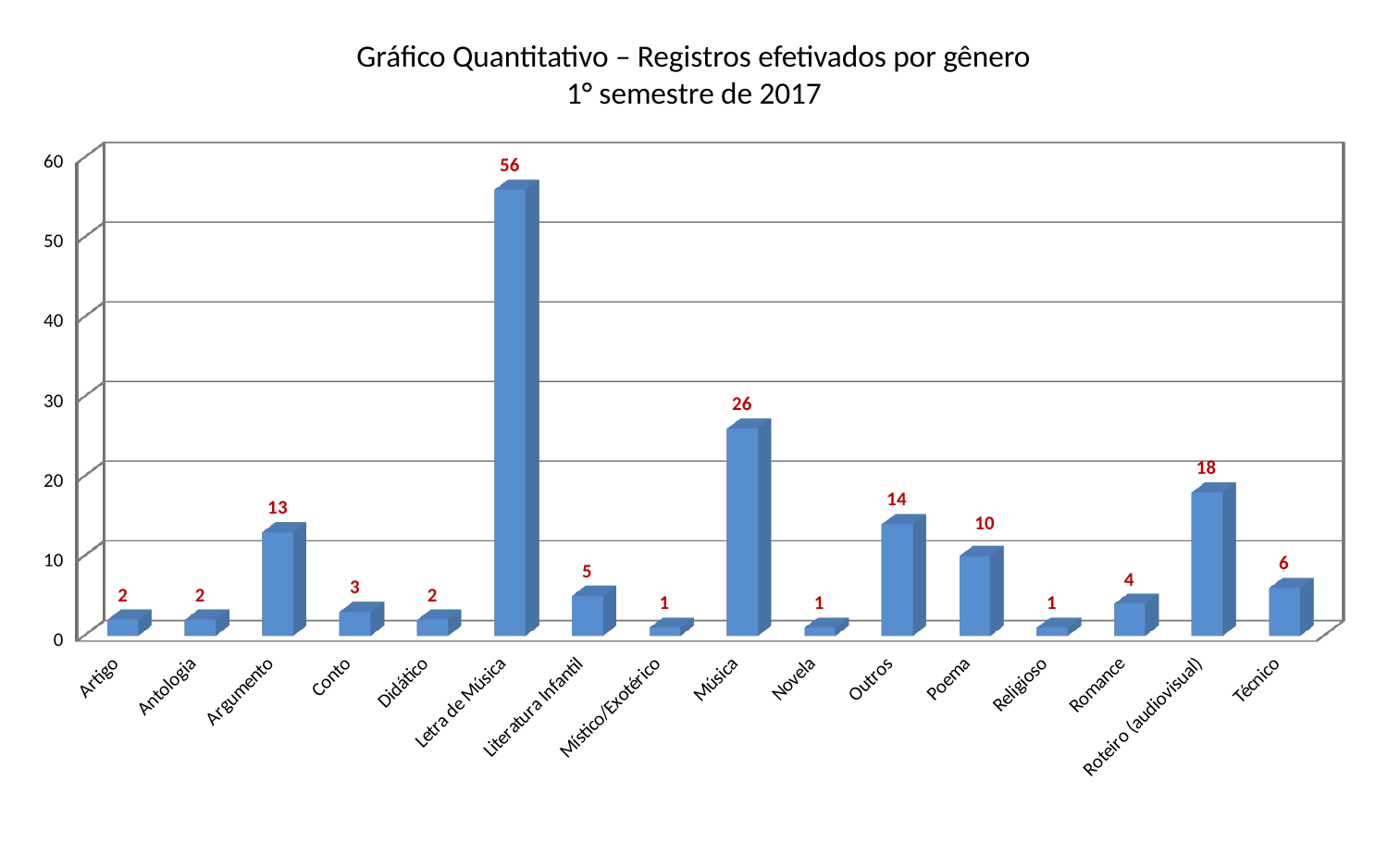
How many categories are shown on the x axis? 16 What is the difference between the values for Letra de Música and Música? 30 Which category has the highest value? Letra de Música Is the value for Música greater or less than 20? greater What is the difference between the values for Outros and Argumento? 1 What is the title of the chart? Gráfico Quantitativo – Registros efetivados por gênero 1° semestre de 2017 What is the value for Roteiro (audiovisual)? 18 What is the value for Letra de Música? 56 What kind of chart is shown on the slide? bar chart What is the value for Literatura Infantil? 5 What is the value for Poema? 10 Which is larger, the value for Música or the value for Roteiro (audiovisual)? Música